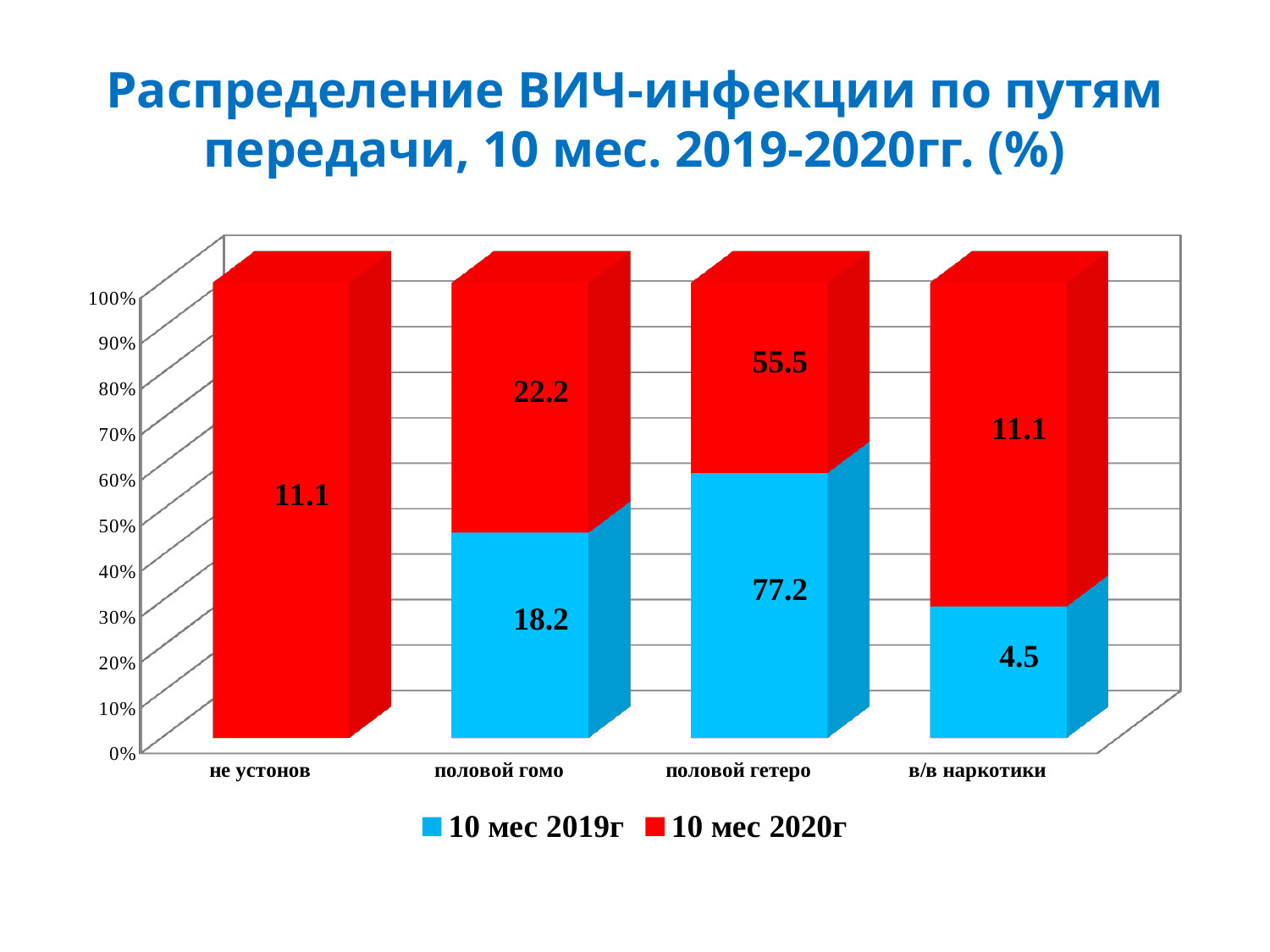
What is the value for не устонов in the 10 мес 2020г series? 11.1 What is the value for половой гетеро in the 10 мес 2019г series? 77.2 How many categories are shown on the x axis? 4 What is the difference between the 10 мес 2019г and 10 мес 2020г values for половой гетеро? 21.7 What is the value for половой гомо in the 10 мес 2020г series? 22.2 Which category has the lowest labelled value in the 10 мес 2019г series? в/в наркотики For половой гомо, which series has the larger value, 10 мес 2019г or 10 мес 2020г? 10 мес 2020г What kind of chart is shown on the slide? Stacked bar chart Which category has the highest value in the 10 мес 2020г series? половой гетеро What is the value for в/в наркотики in the 10 мес 2019г series? 4.5 What is the difference between the 10 мес 2020г and 10 мес 2019г values for в/в наркотики? 6.6 How many series does the legend list? 2